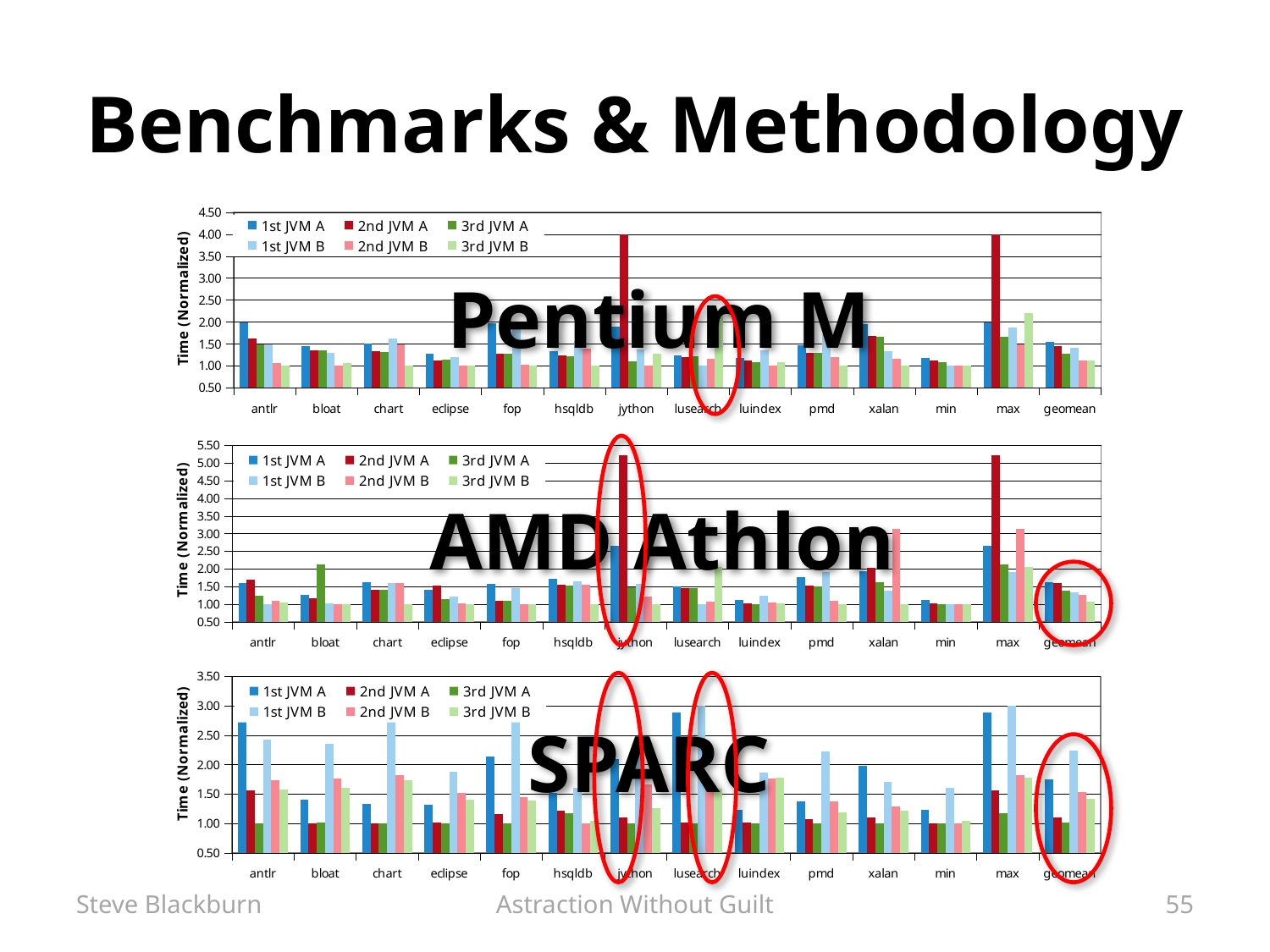
What is the y-axis title of the SPARC chart? Time (Normalized) In the SPARC chart, is the value of 1st JVM A for antlr greater or less than 2.00? greater In the SPARC chart, which is larger for antlr: 1st JVM A or 2nd JVM A? 1st JVM A In the Pentium M chart, is the value of 2nd JVM A for jython greater or less than 3.00? greater In the AMD Athlon chart, is the value of 2nd JVM A for jython greater or less than 4.00? greater How many categories are shown along the x axis of the SPARC chart? 14 What is the name of the first series listed in the legend of the Pentium M chart? 1st JVM A How many series does the legend of the AMD Athlon chart list? 6 In the AMD Athlon chart, which category has the tallest bar? jython and max (tied) What kind of chart is the Pentium M chart? bar chart